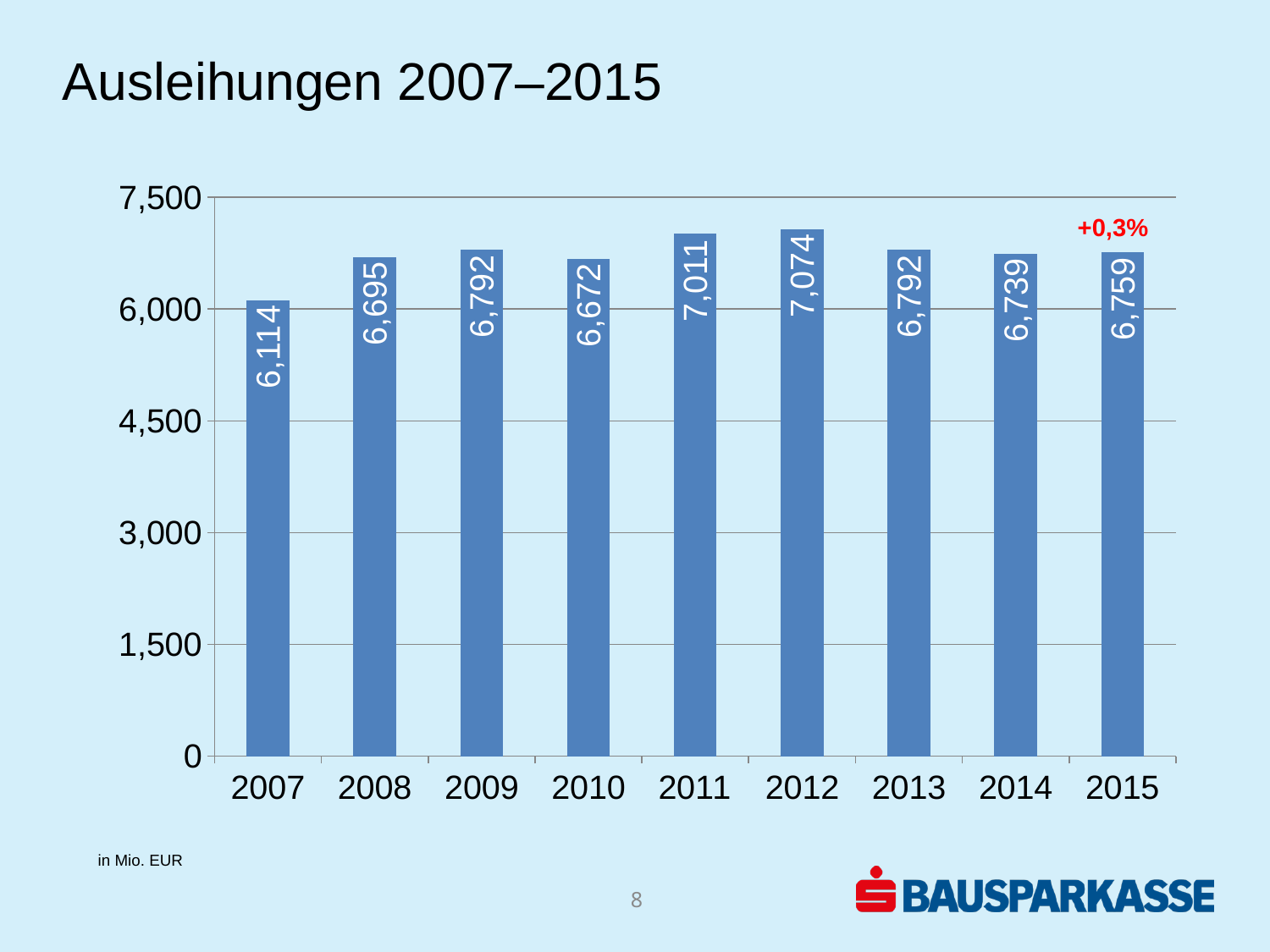
What is the value for 2015? 6,759 Which year has the lowest value? 2007 What is the difference between the values for 2015 and 2014? 20 What is the value for 2007? 6,114 Is the value for 2007 greater or less than 6,000? greater What is the value for 2012? 7,074 How many years are shown on the x axis? 9 What is the difference between the values for 2012 and 2007? 960 What kind of chart is shown on the slide? bar chart Which is larger, the value for 2011 or the value for 2010? 2011 What percentage change is annotated in red above the 2015 bar? +0,3% Which year has the highest value? 2012